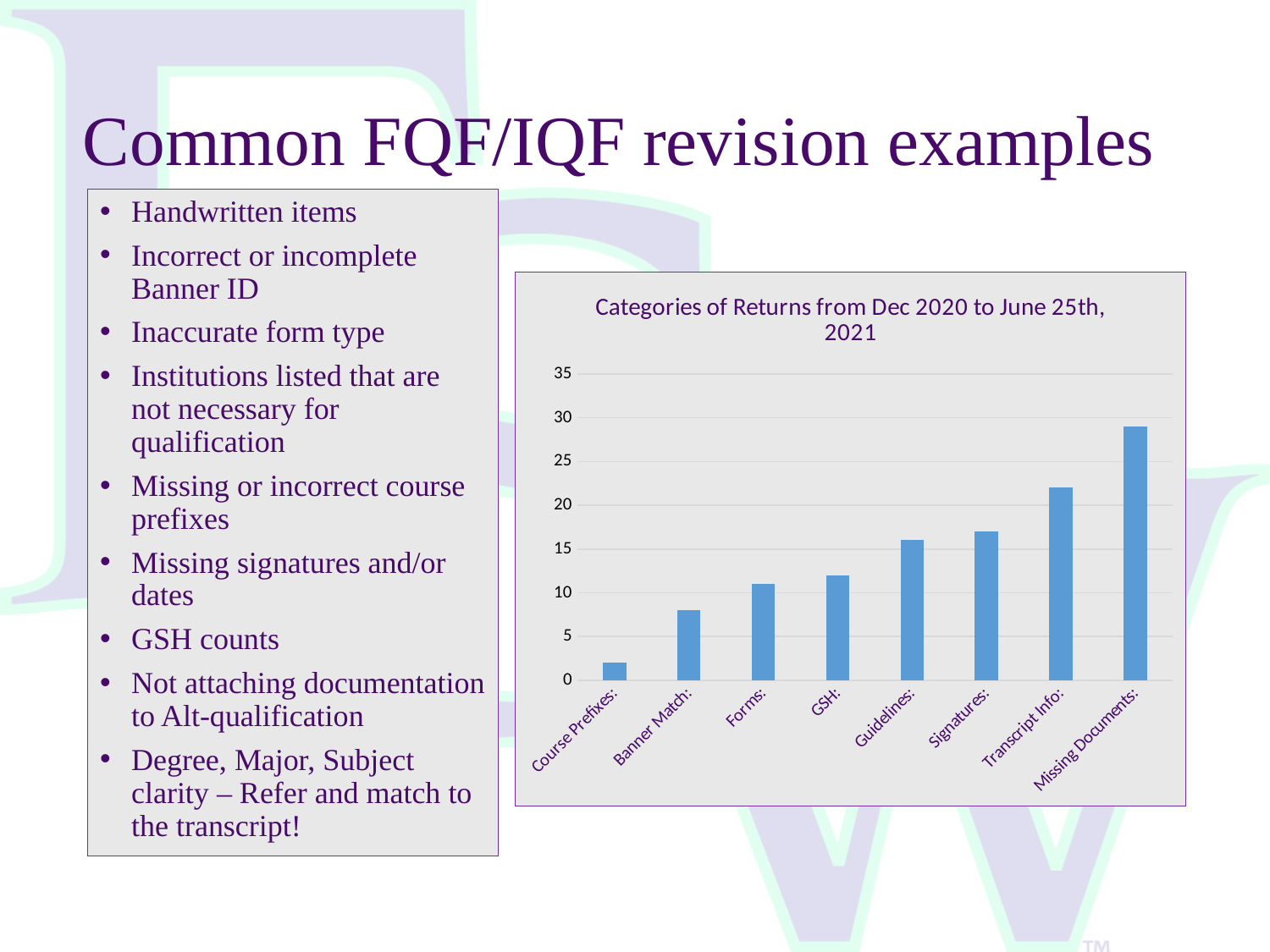
Which is larger, the value for Signatures or the value for Banner Match? Signatures: Is the value for Transcript Info greater or less than 20? greater Do the values rise or fall moving from left to right along the x axis? rise What type of chart is shown on the slide? bar chart Is the value for Banner Match greater or less than 10? less What is the highest value shown on the vertical axis of the chart? 35 How many categories are shown on the x axis of the chart? 8 Which category has the highest value in the chart? Missing Documents: What is the title of the chart? Categories of Returns from Dec 2020 to June 25th, 2021 Is the value for Missing Documents greater or less than 25? greater Which category has the lowest value in the chart? Course Prefixes: